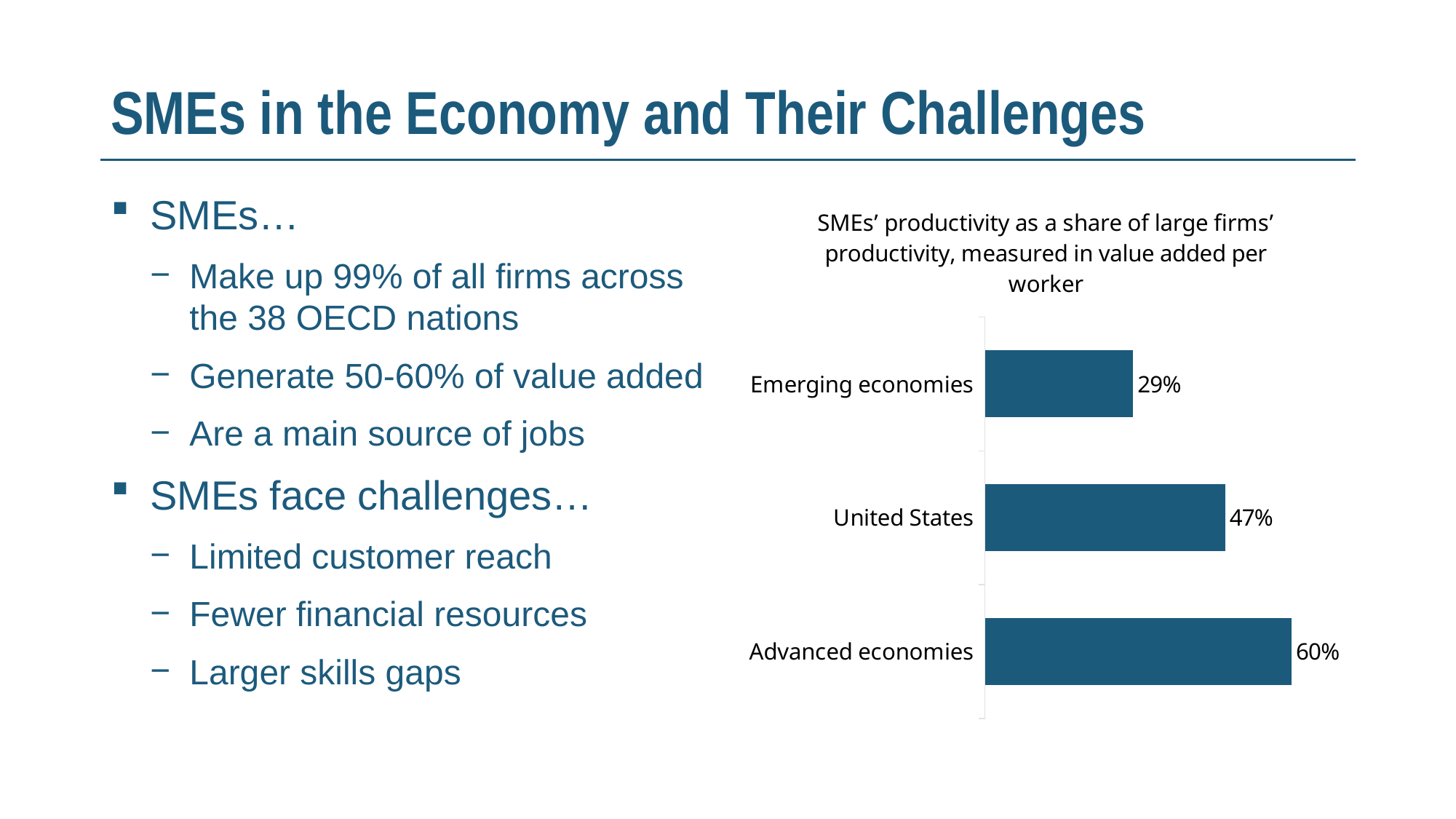
What is the value for United States? 47% What colour are the bars in the chart? Dark blue What is the difference between the values for United States and Emerging economies? 18% What is the value for Emerging economies? 29% What is the value for Advanced economies? 60% What kind of chart is shown on the slide? Bar chart Which category has the highest value? Advanced economies What is the difference between the values for Advanced economies and Emerging economies? 31% Which is larger, the value for United States or the value for Emerging economies? United States What is the title of the chart? SMEs' productivity as a share of large firms' productivity, measured in value added per worker How many categories are shown in the chart? 3 Which category has the lowest value? Emerging economies